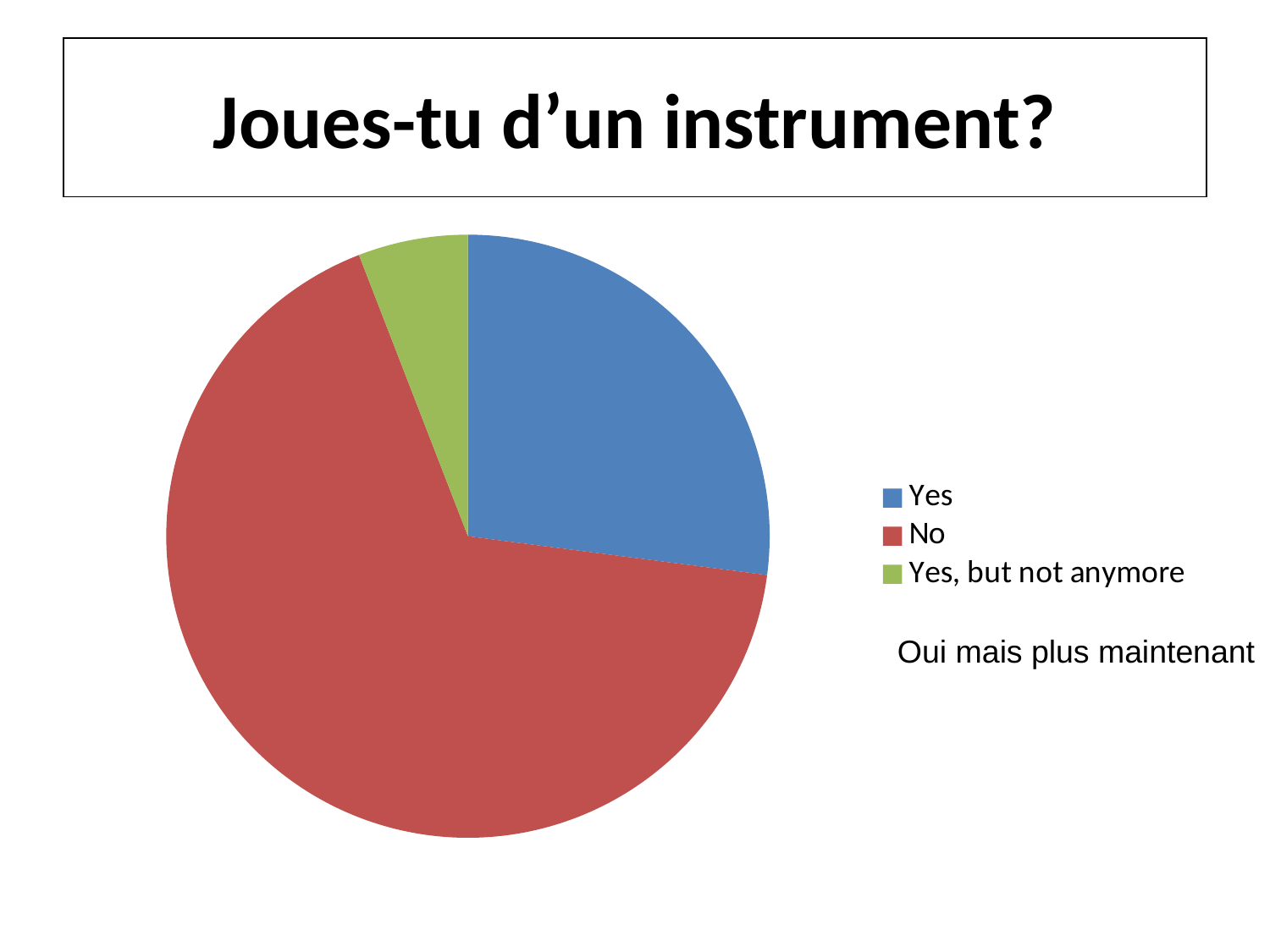
Which slice is larger, Yes or Yes, but not anymore? Yes What is the title of the slide containing the chart? Joues-tu d'un instrument? What colour is the slice for No? red Which slice is larger, Yes or No? No What kind of chart is shown on the slide? pie chart Which category has the smallest slice of the pie? Yes, but not anymore How many slices does the pie chart have? 3 How many entries does the legend list? 3 Which category has the largest slice of the pie? No